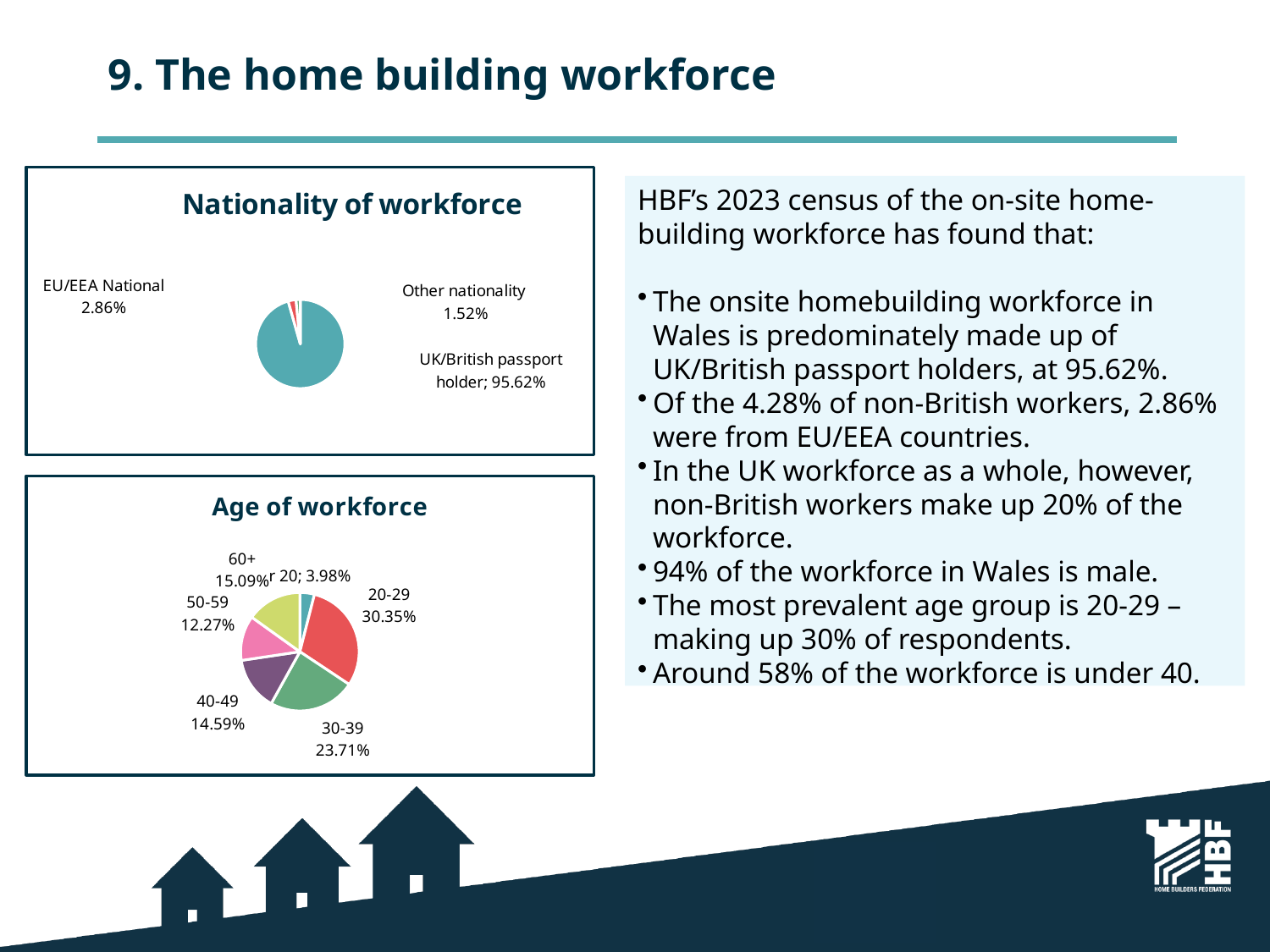
In the 'Age of workforce' chart, which is larger: the 40-49 share or the 50-59 share? 40-49 In the 'Nationality of workforce' chart, which category has the smallest slice? Other nationality In the 'Age of workforce' chart, what is the value for the 60+ age group? 15.09% In the 'Age of workforce' chart, what is the value for the 20-29 age group? 30.35% In the 'Age of workforce' chart, what is the value for the 30-39 age group? 23.71% In the 'Nationality of workforce' chart, what is the value for EU/EEA National? 2.86% In the 'Nationality of workforce' chart, what share of the workforce are UK/British passport holders? 95.62% In the 'Age of workforce' chart, how many slices does the pie have? 6 In the 'Nationality of workforce' chart, what is the value for Other nationality? 1.52% In the 'Age of workforce' chart, which age group has the largest share? 20-29 In the 'Nationality of workforce' chart, what is the difference between the EU/EEA National and Other nationality shares? 1.34% What type of chart is the 'Age of workforce' chart? Pie chart